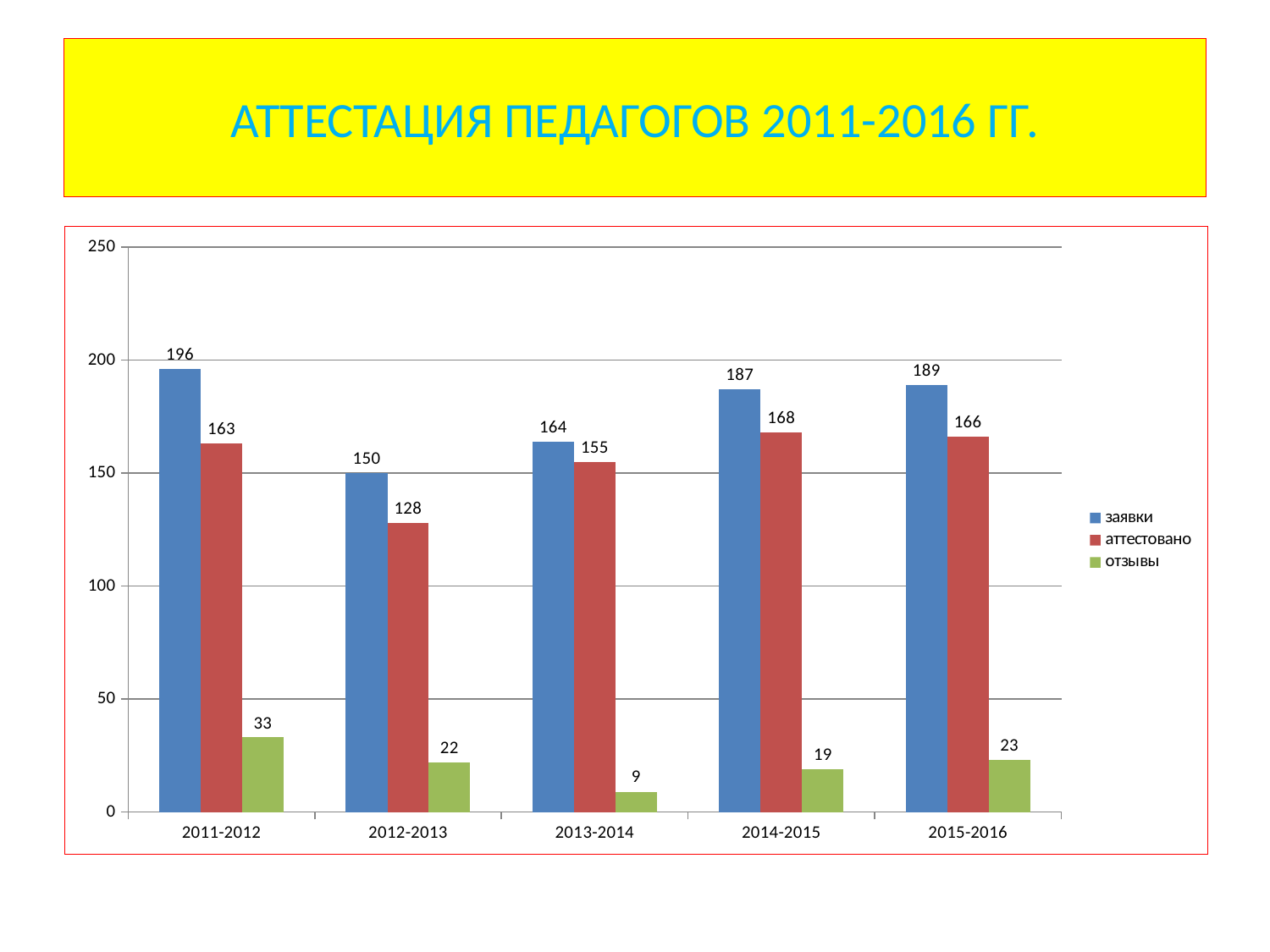
Which period has the highest value for заявки? 2011-2012 What is the title of the slide? АТТЕСТАЦИЯ ПЕДАГОГОВ 2011-2016 ГГ. Which period has the lowest value for отзывы? 2013-2014 What is the difference between заявки and аттестовано in 2012-2013? 22 How many periods are shown on the x axis? 5 Is the value of аттестовано for 2013-2014 greater or less than 150? greater How many series does the legend list? 3 Which is larger in 2015-2016: заявки or аттестовано? заявки What kind of chart is shown on the slide? bar chart What is the value of заявки for 2011-2012? 196 What is the value of отзывы for 2013-2014? 9 What is the value of аттестовано for 2014-2015? 168